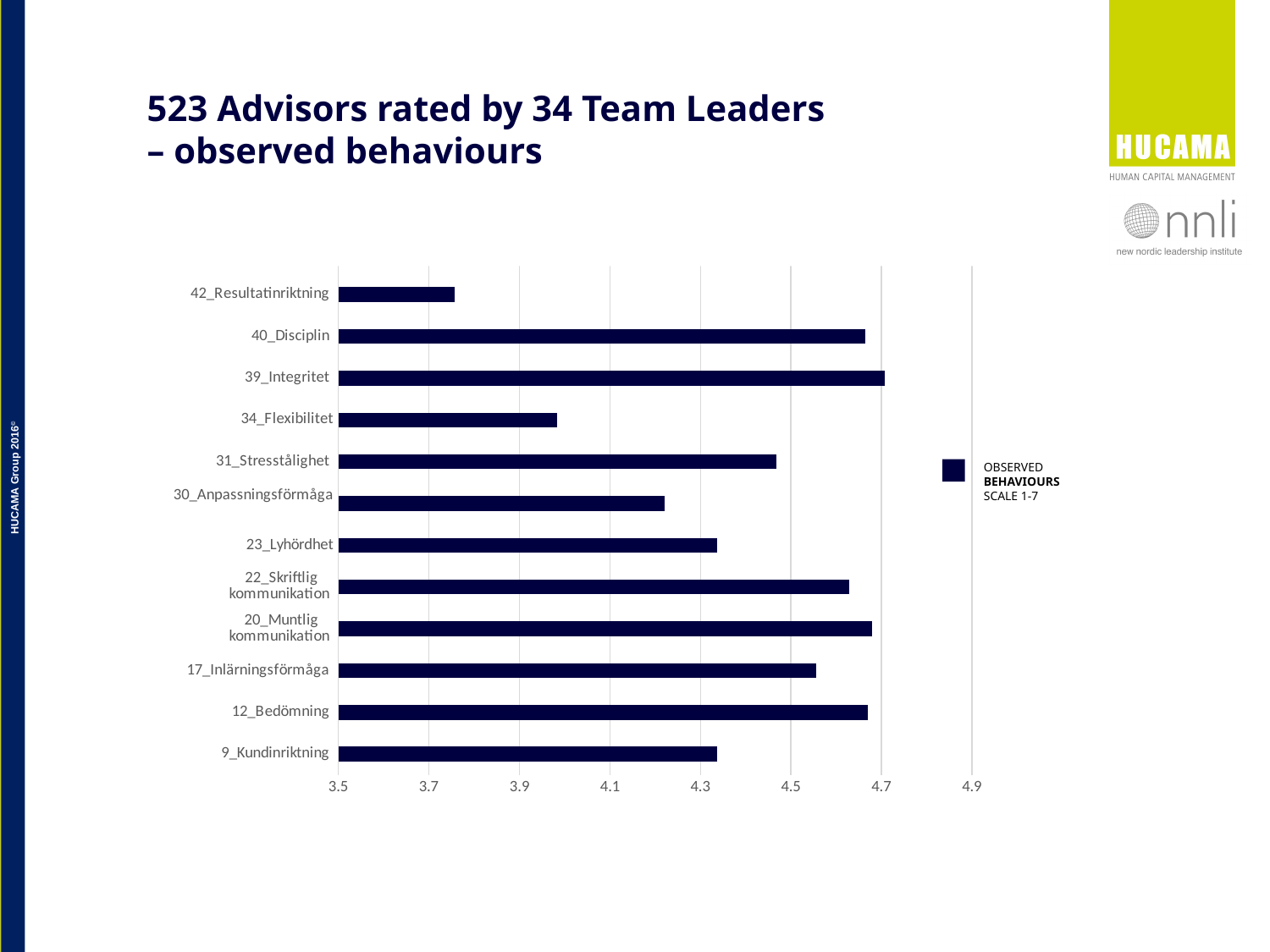
Is the value for 31_Stresstålighet greater or less than 4.5? less How many series does the chart legend list? 1 How many categories (behaviours) are plotted in the chart? 12 Is the value for 34_Flexibilitet greater or less than 4.1? less Is the value for 30_Anpassningsförmåga greater or less than 4.1? greater What is the title of the slide containing the chart? 523 Advisors rated by 34 Team Leaders – observed behaviours Which has the larger value, 31_Stresstålighet or 30_Anpassningsförmåga? 31_Stresstålighet Which has the larger value, 40_Disciplin or 34_Flexibilitet? 40_Disciplin Which category has the lowest value in the chart? 42_Resultatinriktning What kind of chart is shown on the slide? Bar chart